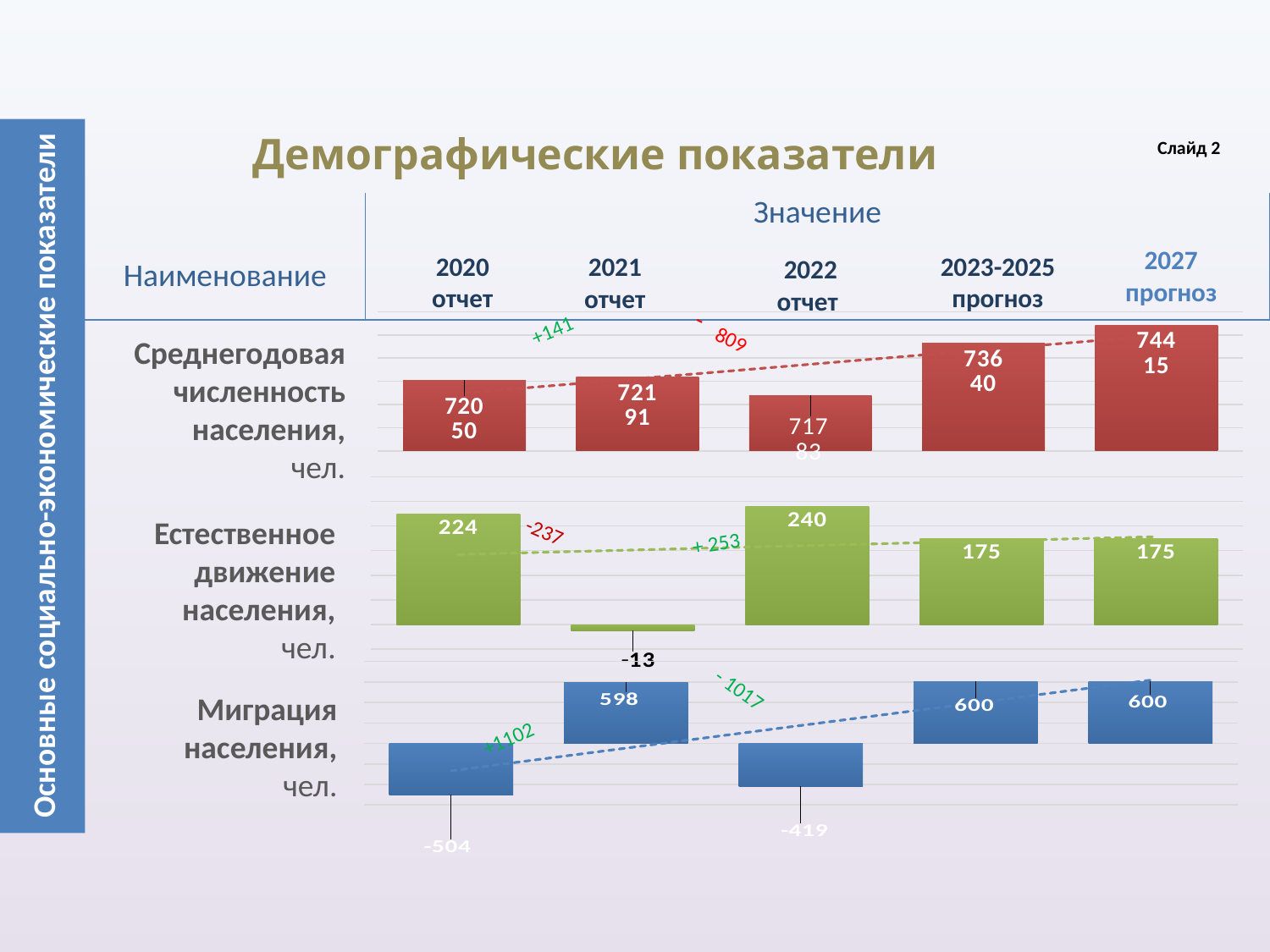
In the 'Миграция населения' chart, what is the value for 2020 отчет? -504 In the 'Миграция населения' chart, which period has the lowest value? 2020 отчет How many time periods (categories) are shown along the x axis of the charts? 5 In the 'Среднегодовая численность населения' chart, which is larger: the value for 2021 отчет or for 2022 отчет? 2021 отчет What kind of chart is used for the 'Миграция населения' row? bar chart In the 'Среднегодовая численность населения' chart, which period has the highest value? 2027 прогноз In the 'Естественное движение населения' chart, what is the value for 2020 отчет? 224 In the 'Миграция населения' chart, what is the value for 2027 прогноз? 600 In the 'Естественное движение населения' chart, what is the difference between the 2022 отчет value and the 2020 отчет value? 16 In the 'Миграция населения' chart, what is the value for 2022 отчет? -419 In the 'Естественное движение населения' chart, which period has the highest value? 2022 отчет In the 'Естественное движение населения' chart, what is the value for 2021 отчет? -13